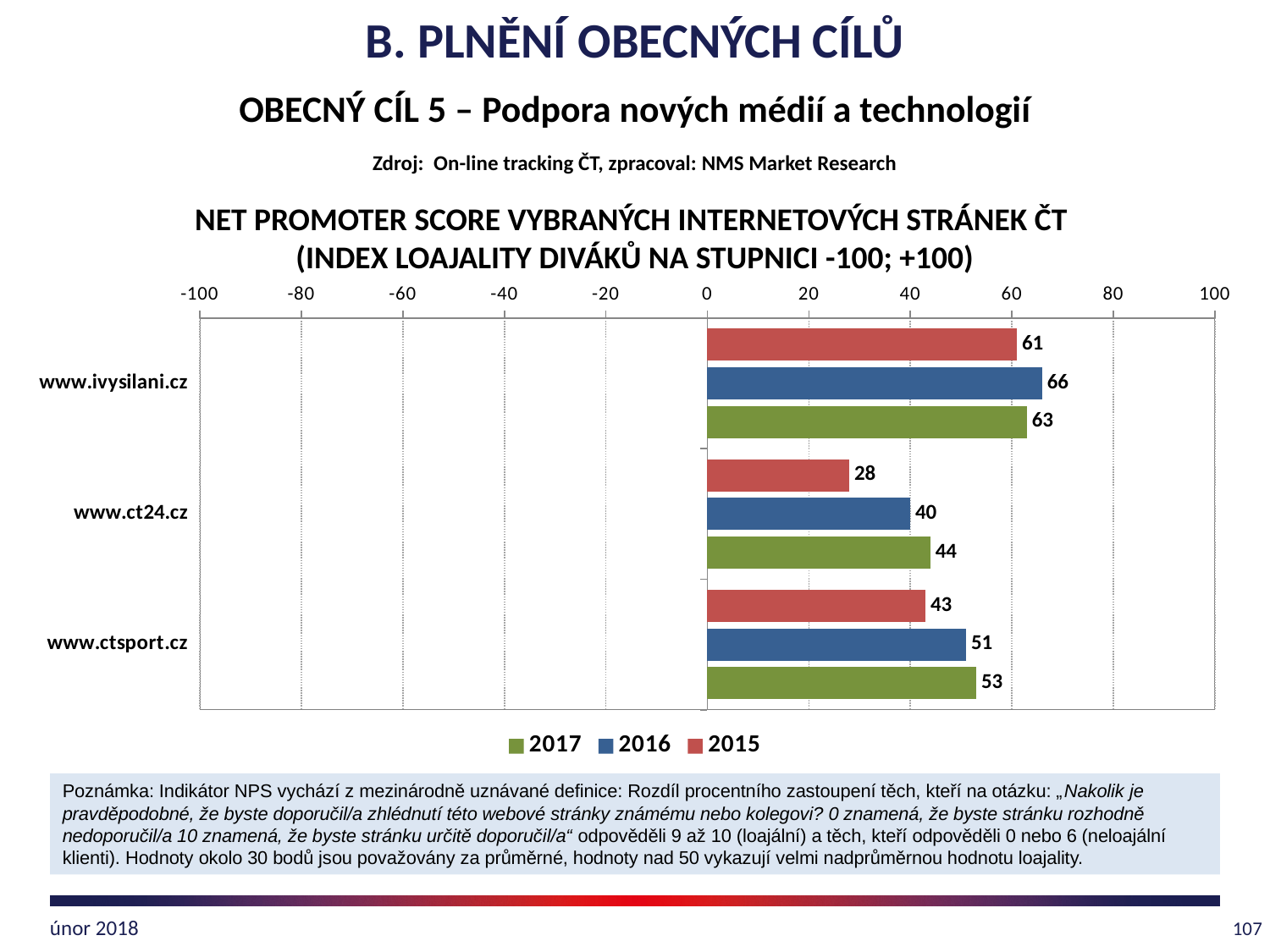
What is the Net Promoter Score for www.ct24.cz in 2015? 28 Which website has the lowest Net Promoter Score in 2015? www.ct24.cz What is the Net Promoter Score for www.ctsport.cz in 2017? 53 Is the 2016 value for www.ctsport.cz greater or less than 40? greater What is the Net Promoter Score for www.ivysilani.cz in 2016? 66 How many series does the legend list? 3 Which is larger for www.ivysilani.cz: the 2017 score or the 2015 score? 2017 How many websites are shown in the chart? 3 What kind of chart is shown on the slide? bar chart Which year is represented by the green bars in the chart? 2017 Which website has the highest Net Promoter Score in 2017? www.ivysilani.cz What is the difference between the 2016 and 2015 Net Promoter Scores for www.ct24.cz? 12